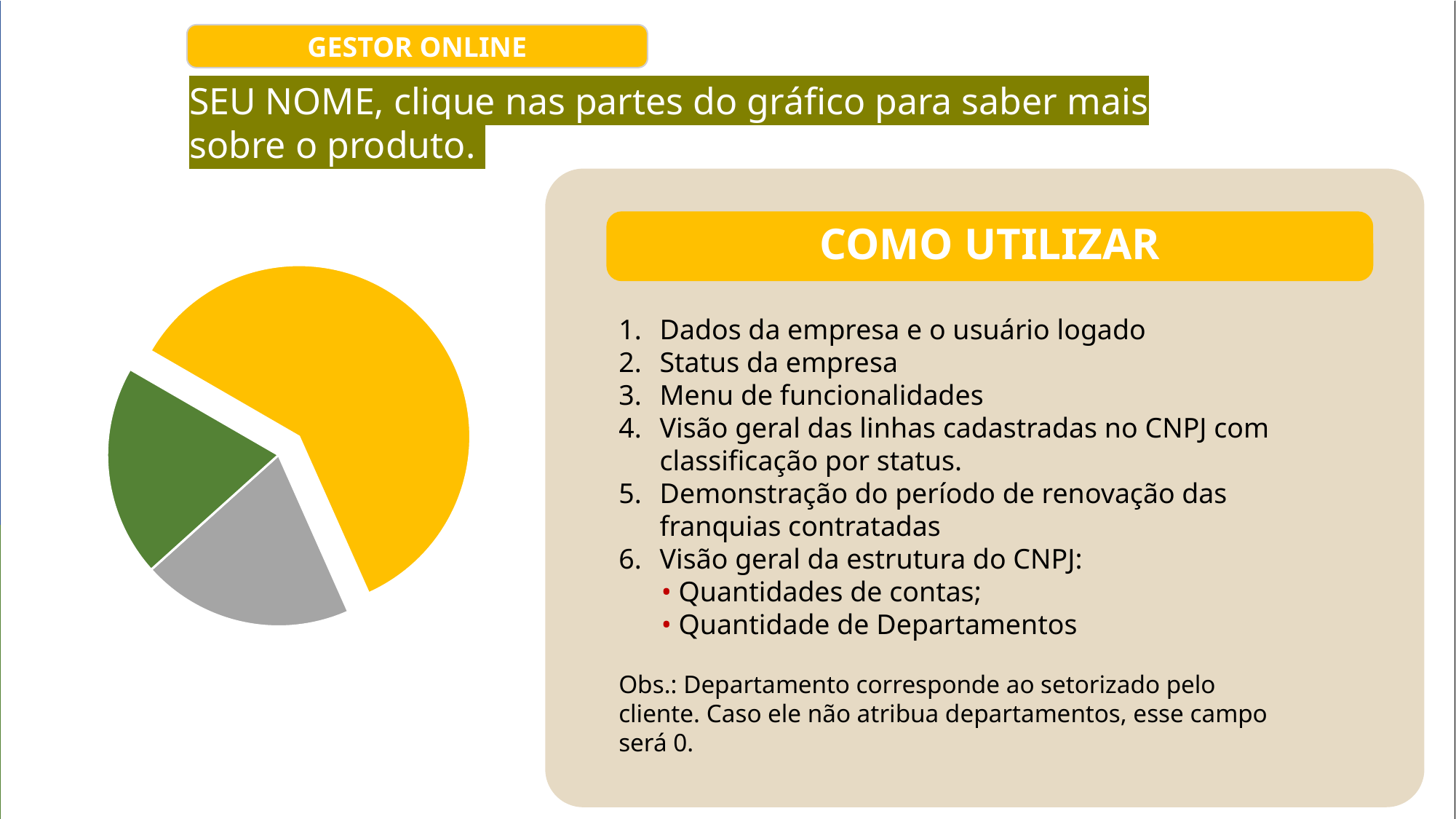
Is the yellow slice or the green slice larger in the pie chart? yellow Does the yellow slice take up more or less than half of the pie chart? more What kind of chart is shown on the left of the slide? pie chart Does the pie chart have a legend? No How many slices does the pie chart have? 3 Is the yellow slice or the gray slice larger in the pie chart? yellow Which colour slice is the largest in the pie chart? yellow What colours are the three slices of the pie chart? yellow, green and gray